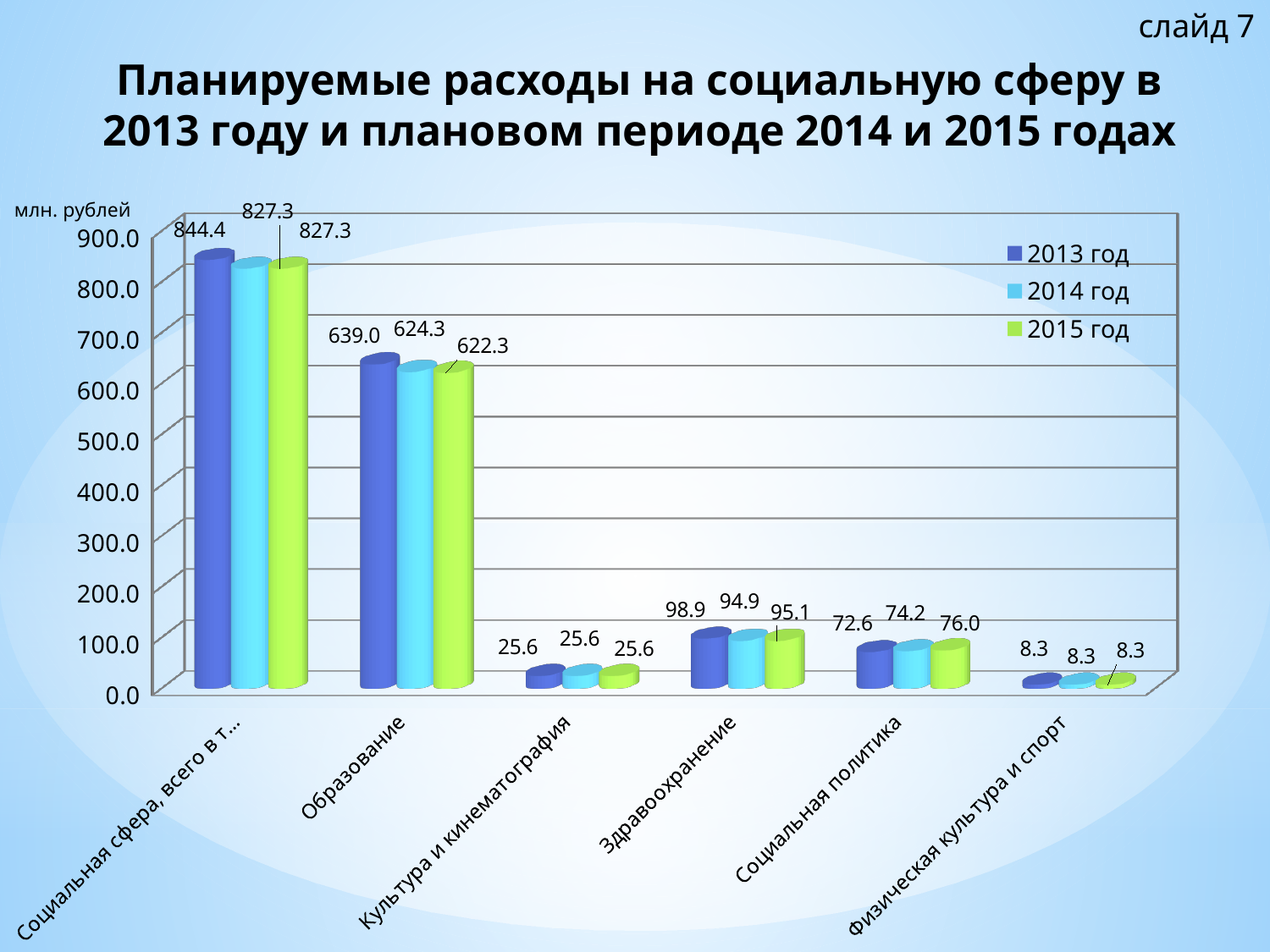
What is the value for Образование in the 2013 год series? 639.0 How many categories are shown on the x axis? 6 What is the value for Здравоохранение in the 2015 год series? 95.1 What is the value for Физическая культура и спорт in the 2013 год series? 8.3 Which category has the highest value in the 2014 год series? Социальная сфера, всего в т... What is the difference between the 2013 год and 2015 год values for Образование? 16.7 Which category has the lowest value in the 2015 год series? Физическая культура и спорт What kind of chart is shown on the slide? Bar chart What is the value for Социальная политика in the 2014 год series? 74.2 How many series does the legend list? 3 What unit is shown above the vertical axis? млн. рублей Which is larger for Социальная политика: the 2013 год value or the 2015 год value? 2015 год